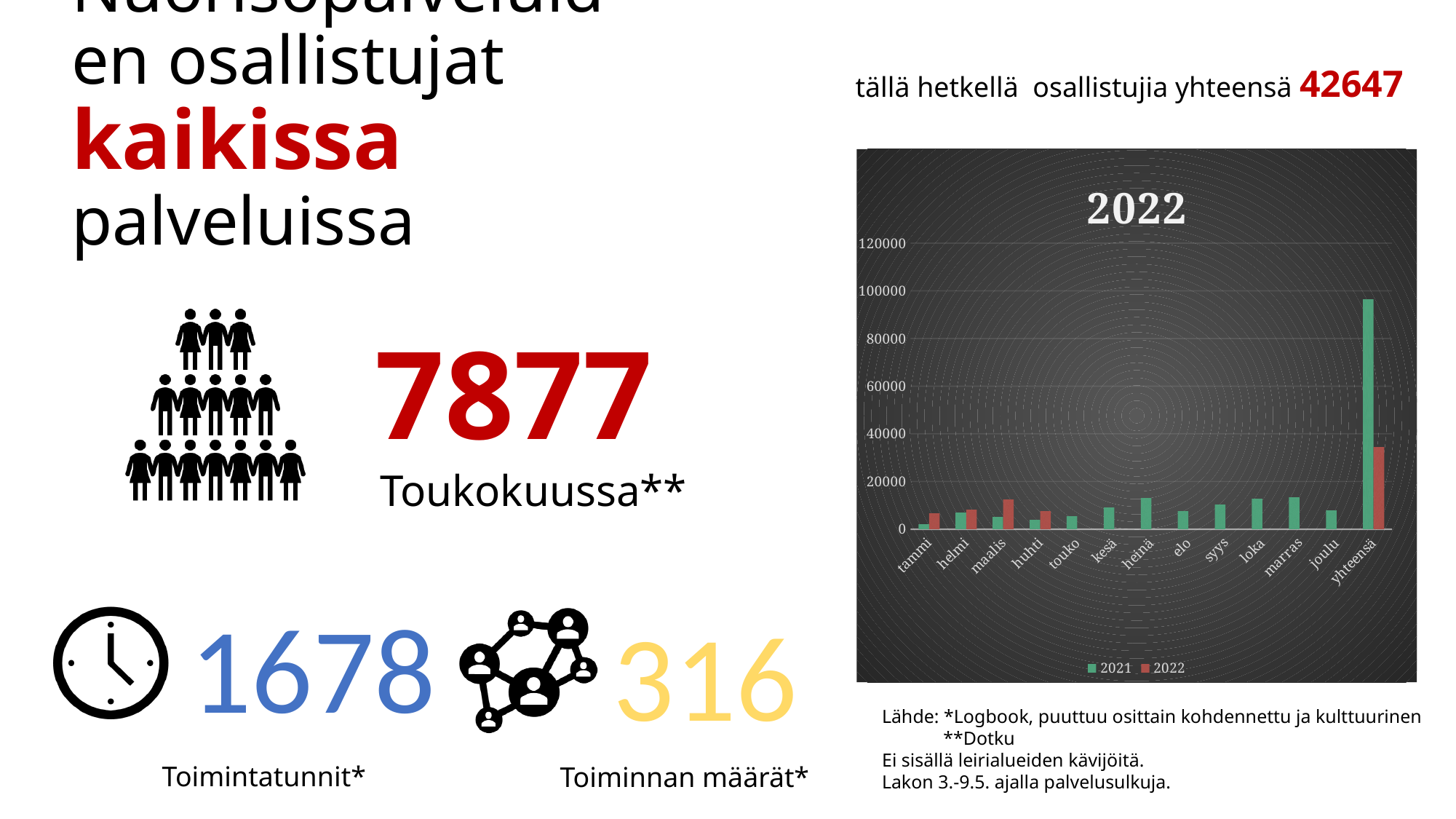
For maalis, which series has the larger value, 2021 or 2022? 2022 Which colour represents the 2022 series in the chart? red Is the 2021 value for yhteensä greater or less than 80000? greater How many series does the chart legend list? 2 Among the monthly categories (excluding yhteensä), which has the lowest value for the 2021 series? tammi What kind of chart is shown on the slide? bar chart Is the 2022 value for yhteensä greater or less than 40000? less How many categories are shown on the x axis of the chart? 13 Which category has the highest value for the 2021 series? yhteensä What is the title of the chart? 2022 For tammi, which series has the larger value, 2021 or 2022? 2022 Is the 2021 value for heinä greater or less than 20000? less